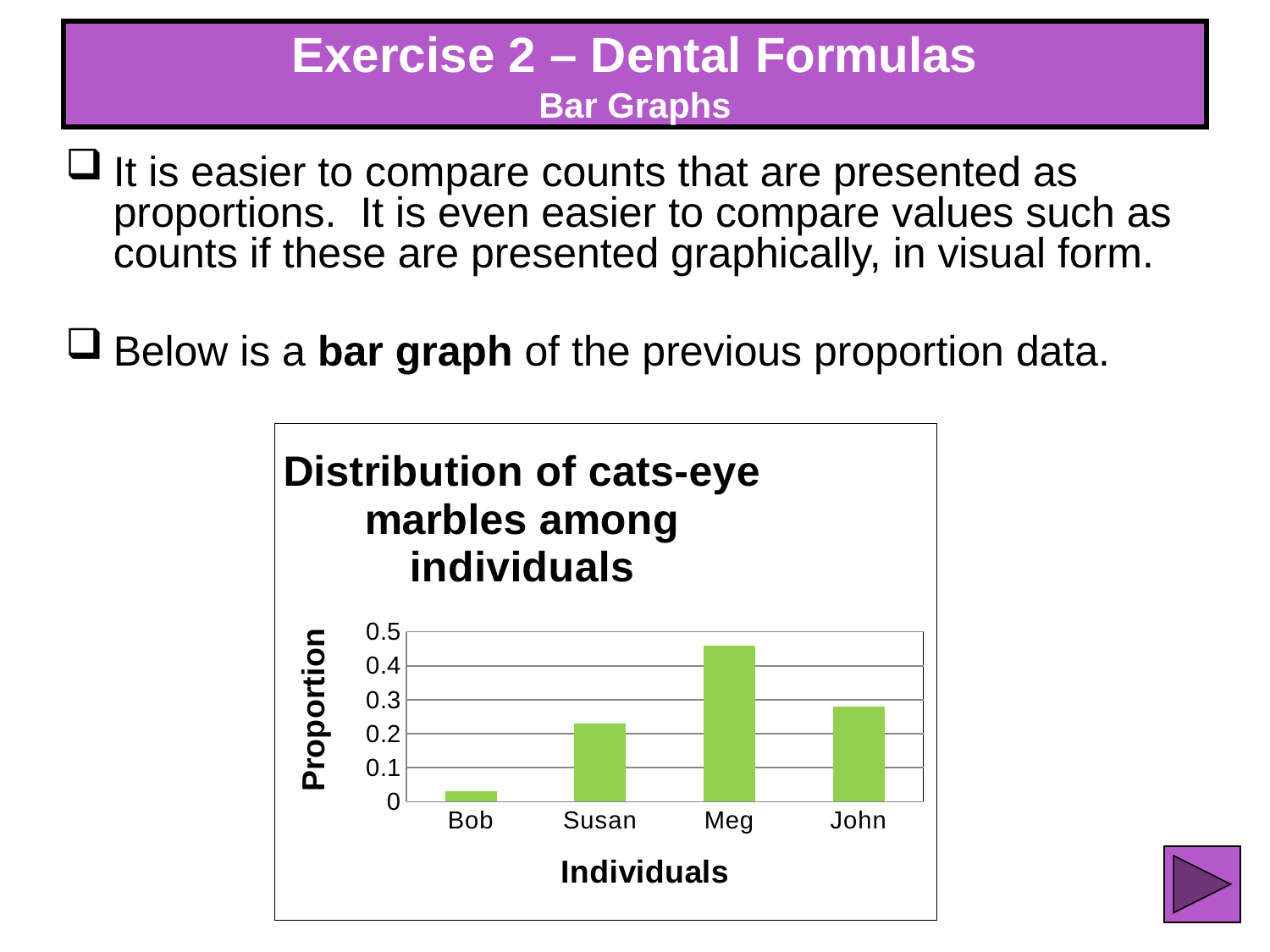
How many individuals are shown on the x axis of the chart? 4 What is the label on the y axis of the chart? Proportion Who has a larger proportion, Meg or John? Meg Is the value for Meg greater or less than 0.4? greater What kind of chart is shown on the slide? bar chart What is the title of the chart? Distribution of cats-eye marbles among individuals Which individual has the lowest proportion of cats-eye marbles? Bob Who has a larger proportion, Susan or Bob? Susan Which individual has the highest proportion of cats-eye marbles? Meg Is the value for John greater or less than 0.2? greater Is the value for Susan greater or less than 0.3? less